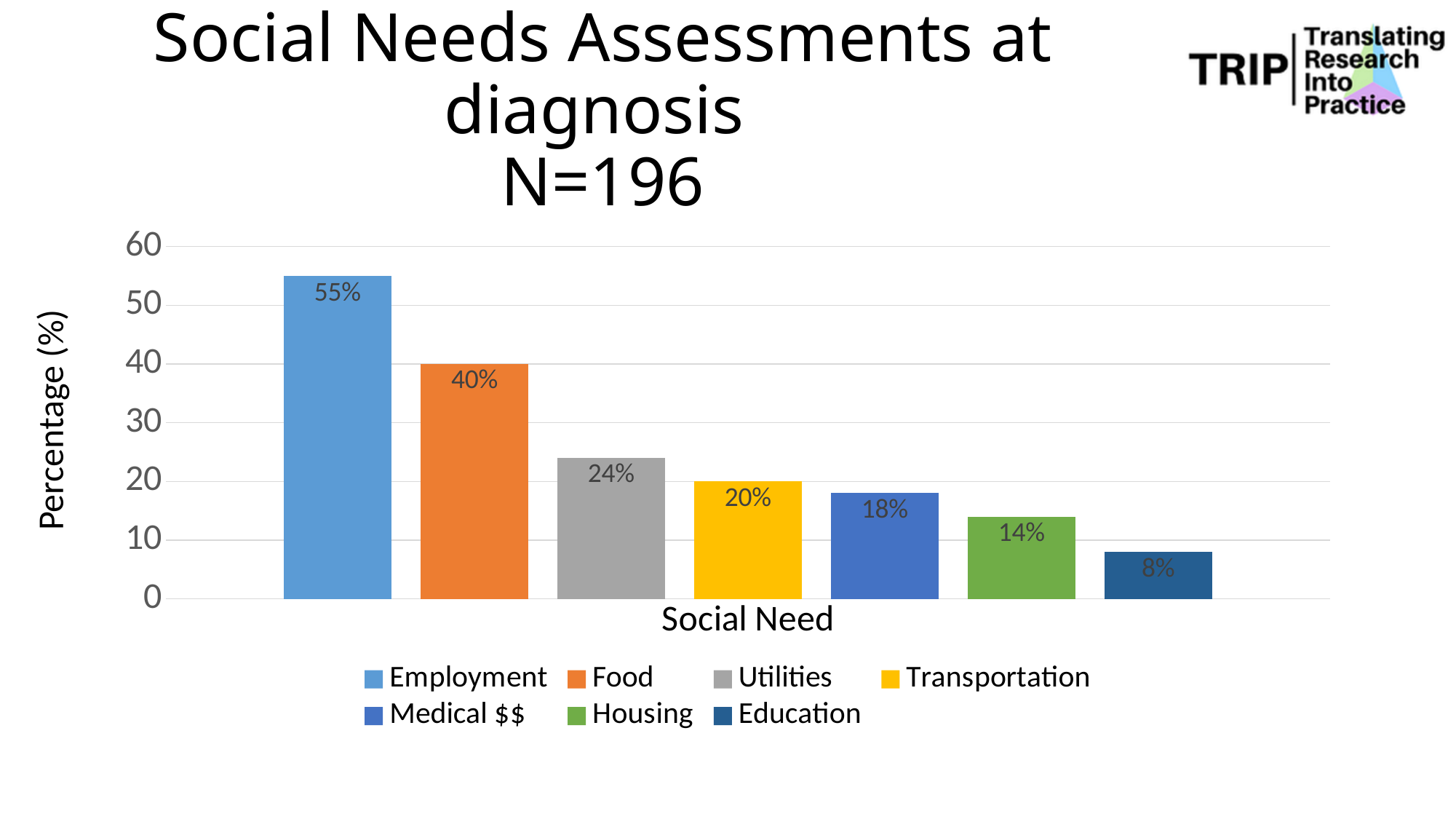
What percentage is shown for Education? 8% What percentage is shown for Medical $$? 18% What is the label of the vertical axis? Percentage (%) Which social need has the lowest percentage? Education What is the difference in percentage points between Employment and Food? 15 What kind of chart is shown on the slide? Bar chart Which is larger, the value for Transportation or the value for Medical $$? Transportation What is the difference in percentage points between Utilities and Housing? 10 What percentage is shown for Food? 40% Which social need has the highest percentage? Employment What percentage is shown for Employment? 55% How many social need categories are plotted in the chart? 7